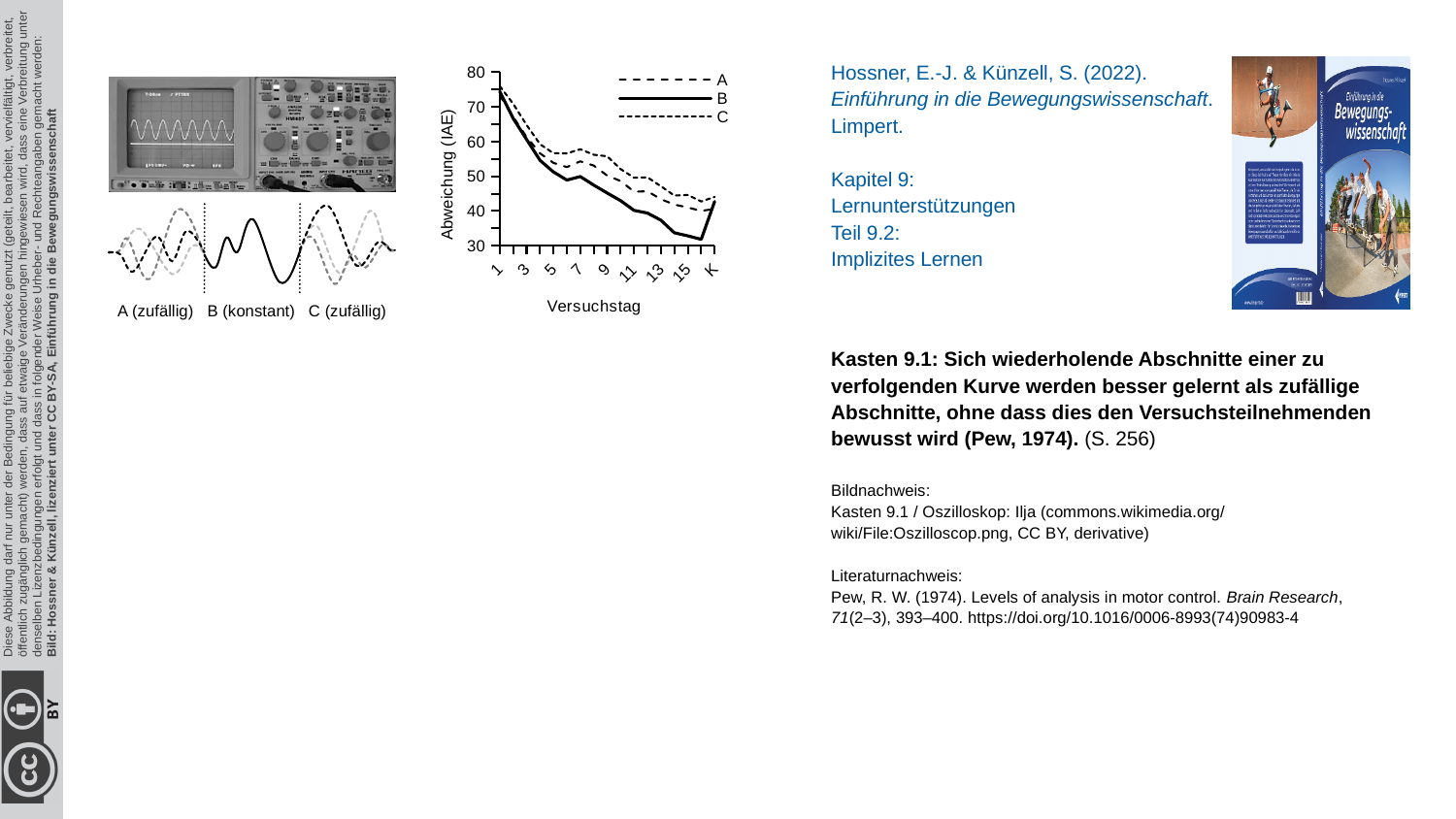
Which series has the lowest value at Versuchstag 15? B At Versuchstag 15, is the value for series A larger or smaller than the value for series B? larger What is the label of the y-axis of the line chart? Abweichung (IAE) Which series has the highest value at Versuchstag 15? C How many series does the legend of the line chart list? 3 What are the series names listed in the legend of the line chart? A, B, C What kind of chart is shown on the slide? line chart Is the value for series B at Versuchstag 15 greater or less than 40? less Do the values for series B rise or fall from Versuchstag 1 to Versuchstag 15? fall How many tick labels are shown on the x-axis (Versuchstag) of the line chart? 9 Which series is drawn as a solid line in the line chart? B Is the value for series A at Versuchstag 1 greater or less than 70? greater